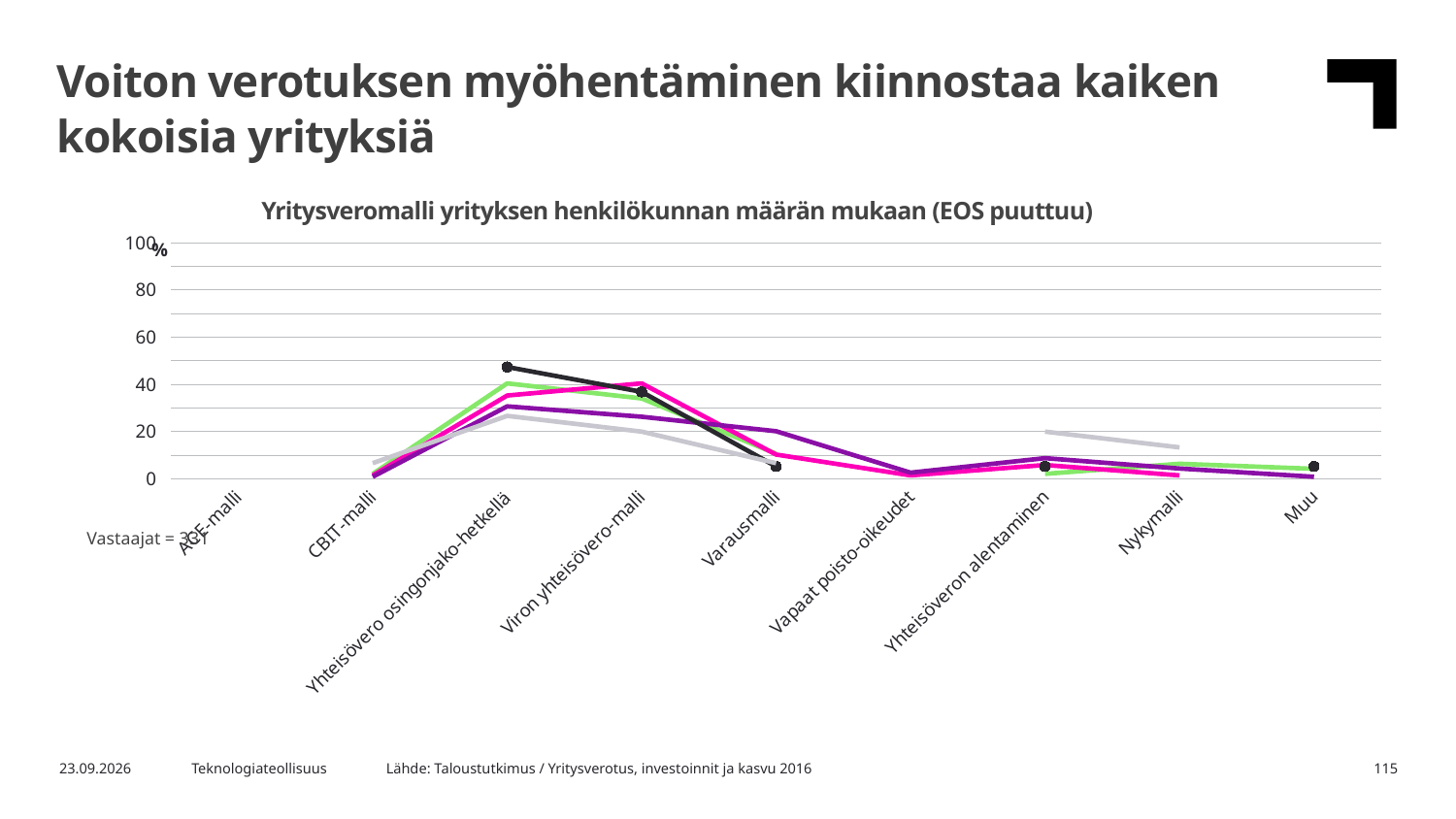
Are the values plotted at Muu greater or less than 20? less What is the maximum value shown on the y axis of the chart? 100 At which category does the highest point of any line occur? Yhteisövero osingonjako-hetkellä Do the lines generally rise or fall from Viron yhteisövero-malli to Vapaat poisto-oikeudet? fall Are the values plotted at Vapaat poisto-oikeudet greater or less than 20? less What is the title of the chart? Yritysveromalli yrityksen henkilökunnan määrän mukaan (EOS puuttuu) How many categories are shown on the x axis of the chart? 9 Is the highest value plotted at Yhteisövero osingonjako-hetkellä greater or less than 40? greater Do the lines generally rise or fall from CBIT-malli to Yhteisövero osingonjako-hetkellä? rise What kind of chart is shown on the slide? line chart